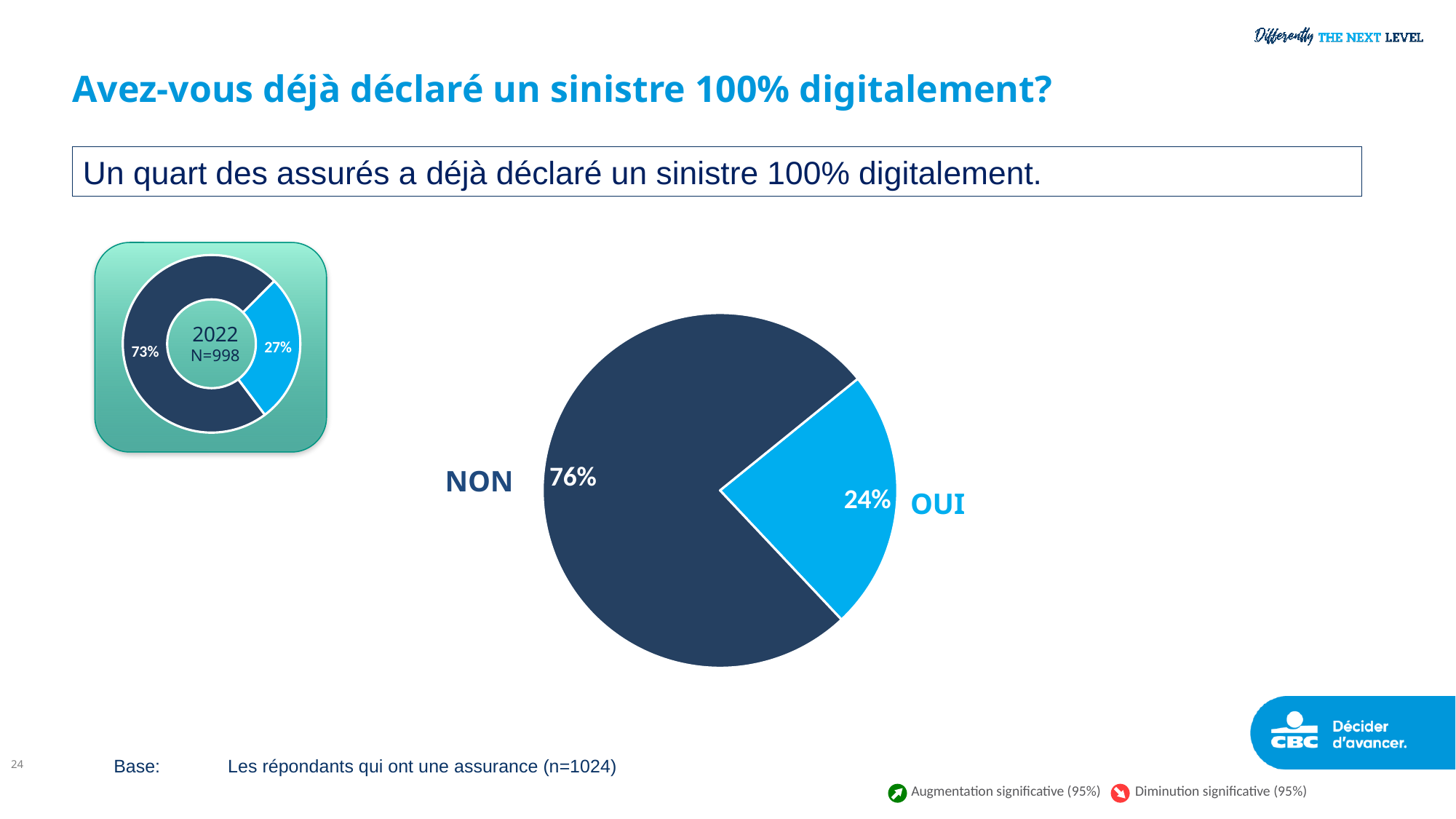
In the large pie chart, what percentage is shown for NON? 76% How many slices does the large pie chart have? 2 In the small donut chart on the left (2022), what percentage is shown in the dark blue segment? 73% In the large pie chart, what is the difference in percentage points between NON and OUI? 52 In the large pie chart, what percentage is shown for OUI? 24% What year is shown in the centre of the small donut chart on the left? 2022 What kind of chart is the large chart in the centre of the slide? Pie chart In the small donut chart on the left (2022), what percentage is shown in the light blue segment? 27% In the large pie chart, which slice is the largest? NON What sample size (N) is shown in the centre of the small donut chart on the left? N=998 In the large pie chart, which is larger, OUI or NON? NON In the large pie chart, which slice is the smallest? OUI